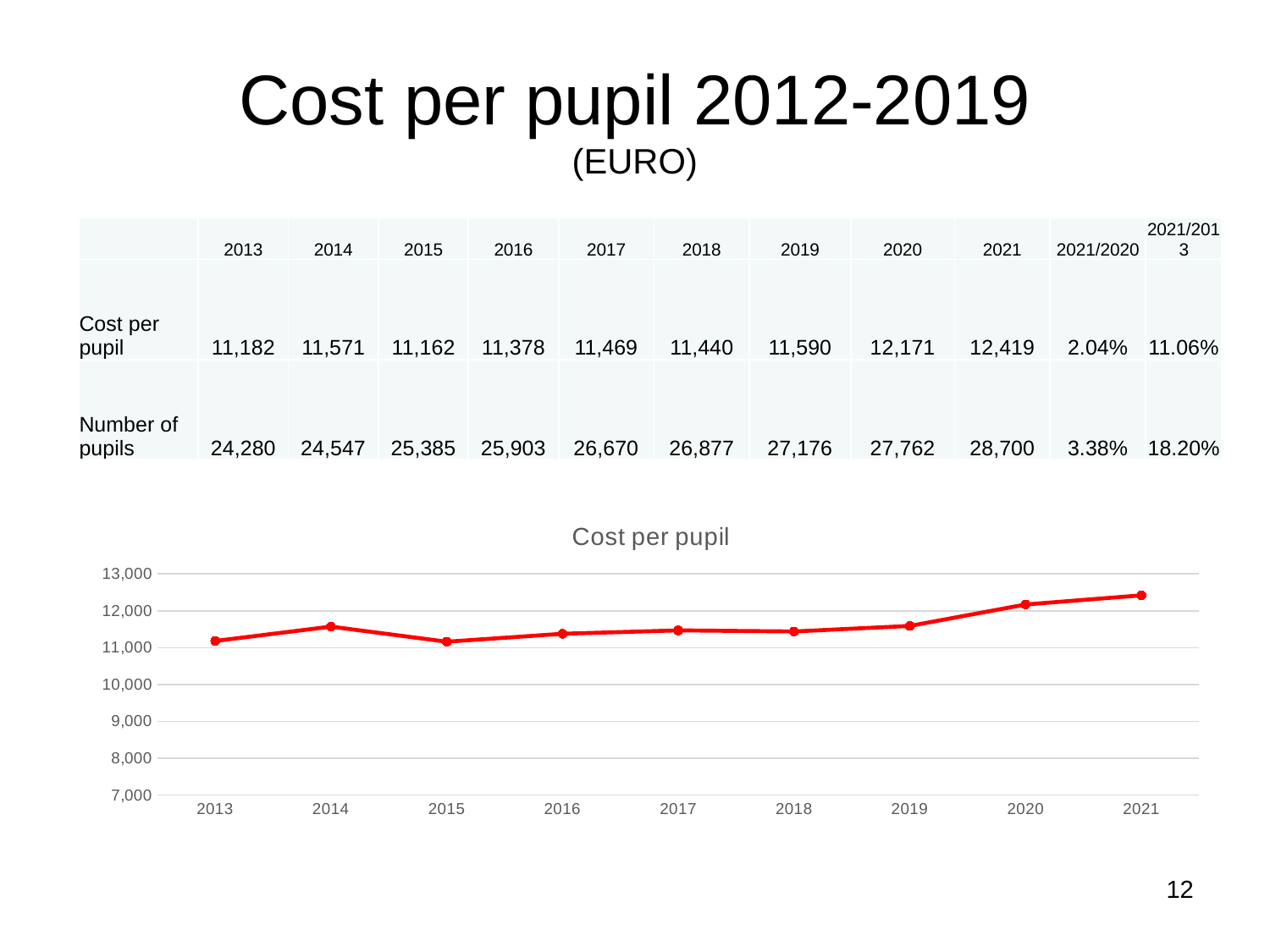
What kind of chart is shown on the slide? line chart According to the table, which year has the lowest cost per pupil? 2015 Does the cost per pupil rise or fall between 2019 and 2021 in the chart? rise What is the title of the chart? Cost per pupil According to the table, what was the cost per pupil in 2021? 12,419 According to the table, what was the cost per pupil in 2013? 11,182 Using the table values, what is the difference in cost per pupil between 2021 and 2020? 248 How many years are plotted on the x axis of the chart? 9 Is the cost per pupil for 2020 greater or less than 12,000 in the chart? greater Which year has the highest cost per pupil in the chart? 2021 Is the cost per pupil for 2018 greater or less than 12,000 in the chart? less According to the table, what was the number of pupils in 2019? 27,176